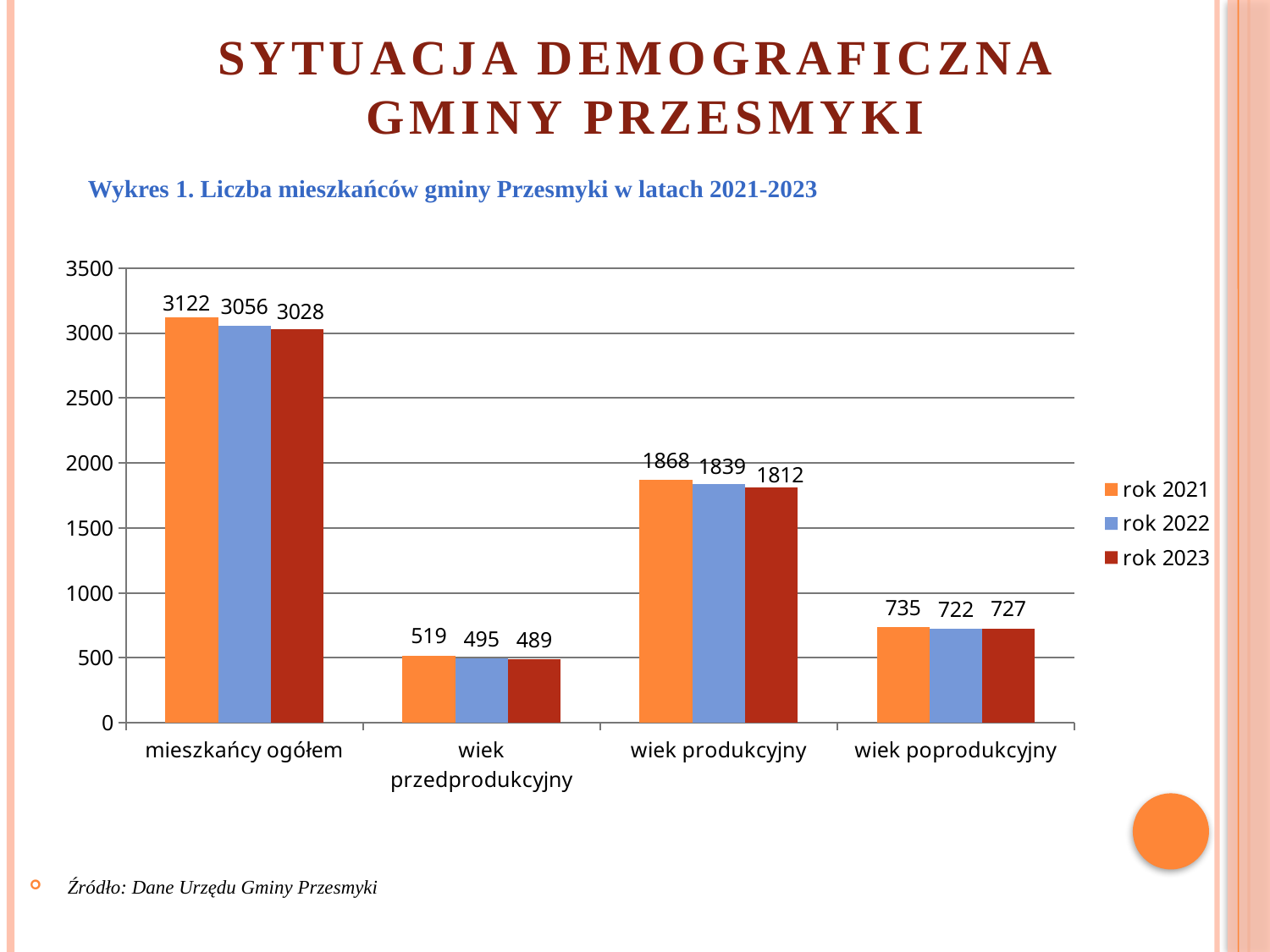
What is the title of the chart? Wykres 1. Liczba mieszkańców gminy Przesmyki w latach 2021-2023 Which category has the lowest value in the 'rok 2022' series? wiek przedprodukcyjny Which is larger for 'wiek poprodukcyjny': the 'rok 2022' value or the 'rok 2023' value? rok 2023 What is the difference between the 'rok 2021' and 'rok 2023' values for 'mieszkańcy ogółem'? 94 What is the value for 'wiek poprodukcyjny' in the 'rok 2021' series? 735 What is the value for 'wiek produkcyjny' in the 'rok 2022' series? 1839 What is the value for 'wiek przedprodukcyjny' in the 'rok 2023' series? 489 What kind of chart is shown on the slide? bar chart Which category has the highest value in the 'rok 2023' series? mieszkańcy ogółem How many series does the legend list? 3 What is the value for 'mieszkańcy ogółem' in the 'rok 2021' series? 3122 How many categories are shown on the x axis? 4